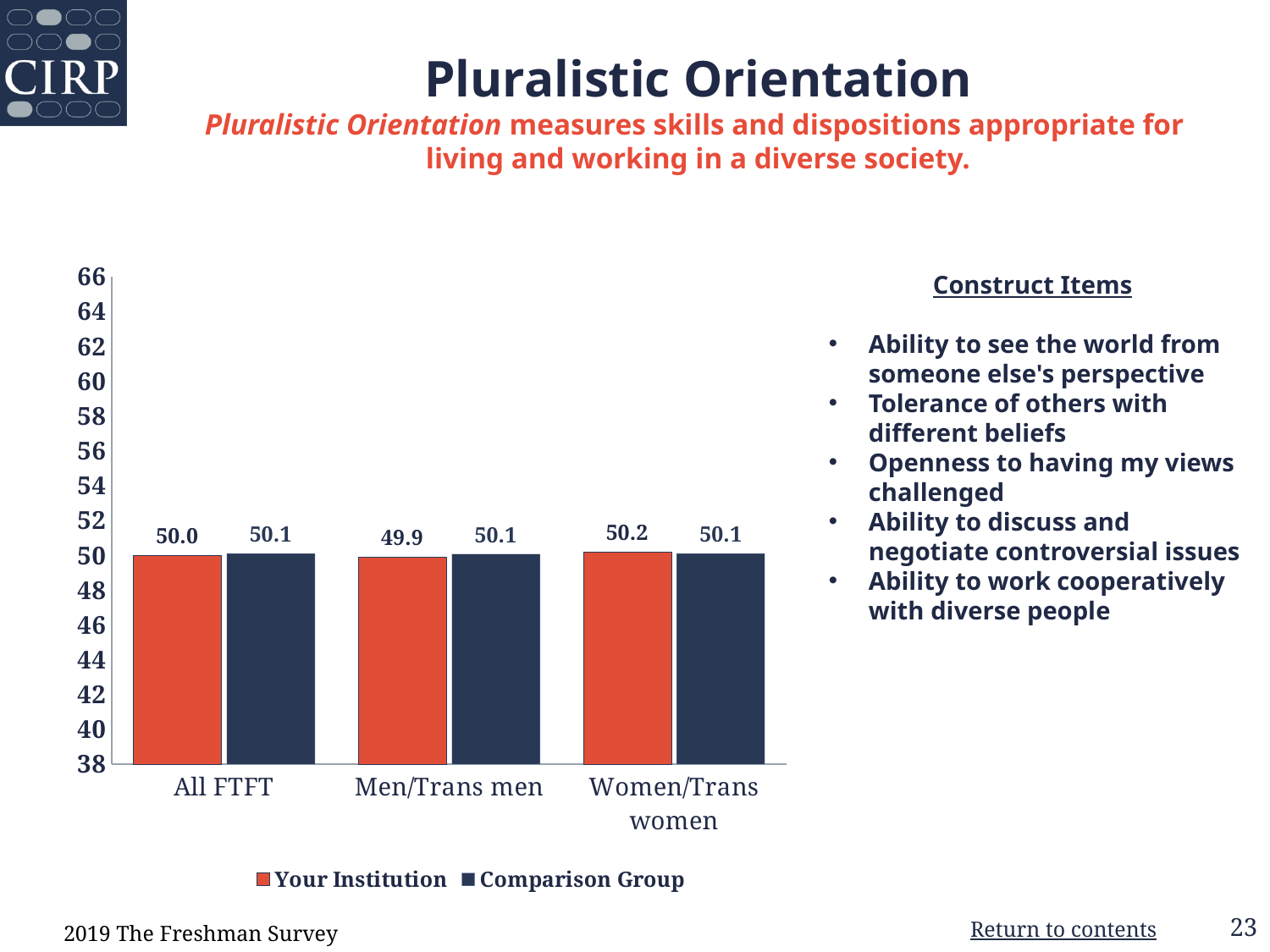
How many series does the legend list? 2 Which category has the highest Your Institution value? Women/Trans women What is the Comparison Group value for Men/Trans men? 50.1 What is the Your Institution value for All FTFT? 50.0 What is the difference between the Your Institution value for Women/Trans women and the Your Institution value for Men/Trans men? 0.3 What is the Your Institution value for Women/Trans women? 50.2 How many categories are shown on the x axis? 3 What is the Your Institution value for Men/Trans men? 49.9 Which series is shown in dark blue in the legend? Comparison Group What kind of chart is shown on the slide? bar chart Which category has the lowest Your Institution value? Men/Trans men What is the difference between the Comparison Group value and the Your Institution value for Men/Trans men? 0.2